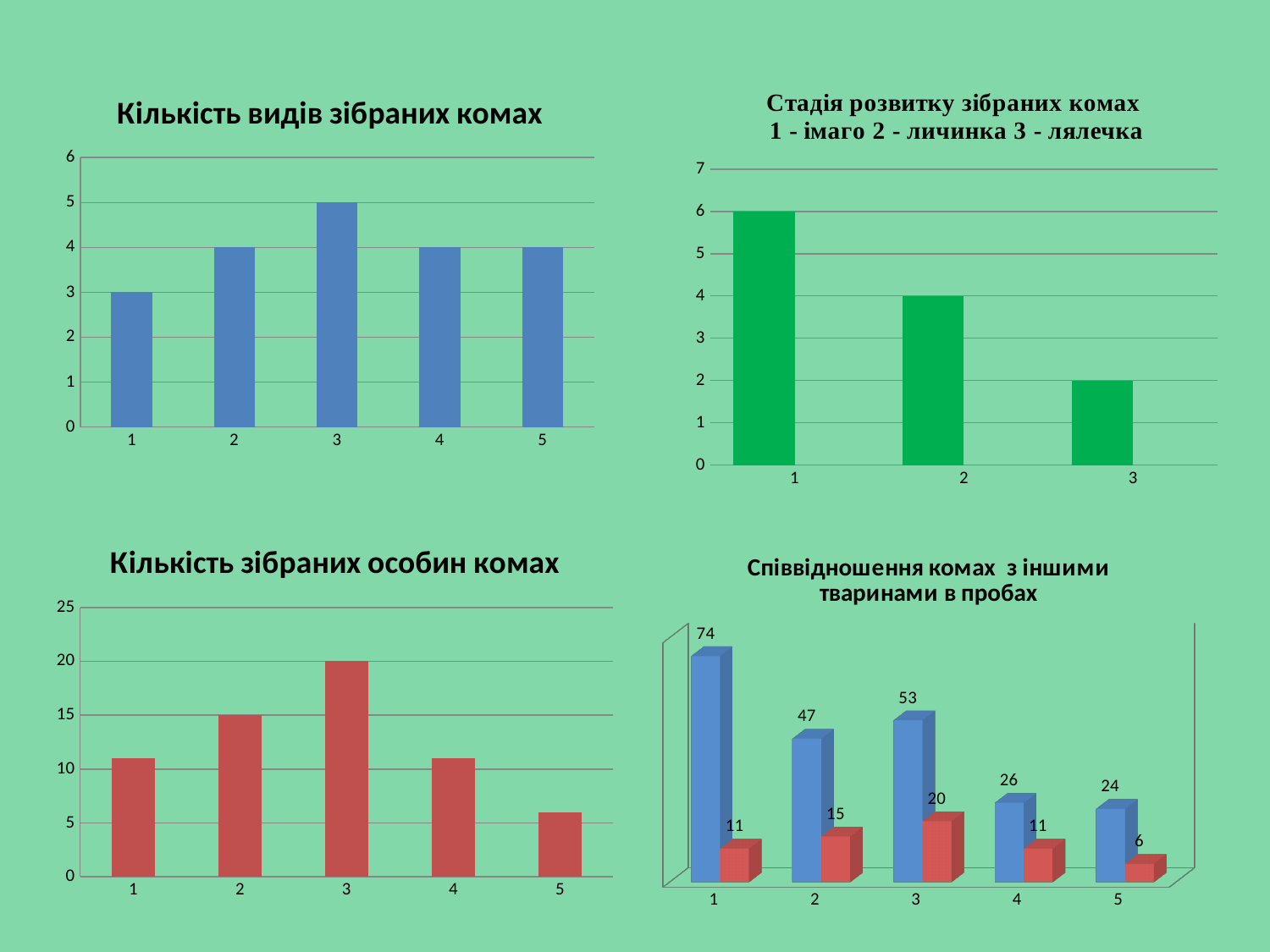
In the chart titled "Кількість видів зібраних комах", which category has the lowest value? 1 In the chart titled "Кількість видів зібраних комах", what is the value for category 3? 5 In the chart titled "Кількість зібраних особин комах", what is the value for category 3? 20 In the chart titled "Співвідношення комах з іншими тваринами в пробах", what is the value of the blue bar for category 1? 74 In the chart titled "Кількість зібраних особин комах", which category has the highest value? 3 In the chart titled "Кількість видів зібраних комах", how many categories are shown on the x axis? 5 What kind of chart is the one titled "Співвідношення комах з іншими тваринами в пробах"? bar chart In the chart titled "Стадія розвитку зібраних комах", what is the value for category 1 (імаго)? 6 In the chart titled "Кількість зібраних особин комах", is the value for category 5 greater or less than 10? less In the chart titled "Стадія розвитку зібраних комах", do the values rise or fall from category 1 to category 3? fall In the chart titled "Стадія розвитку зібраних комах", what is the difference between the values for category 1 and category 3? 4 In the chart titled "Співвідношення комах з іншими тваринами в пробах", what is the difference between the blue and red bars for category 3? 33